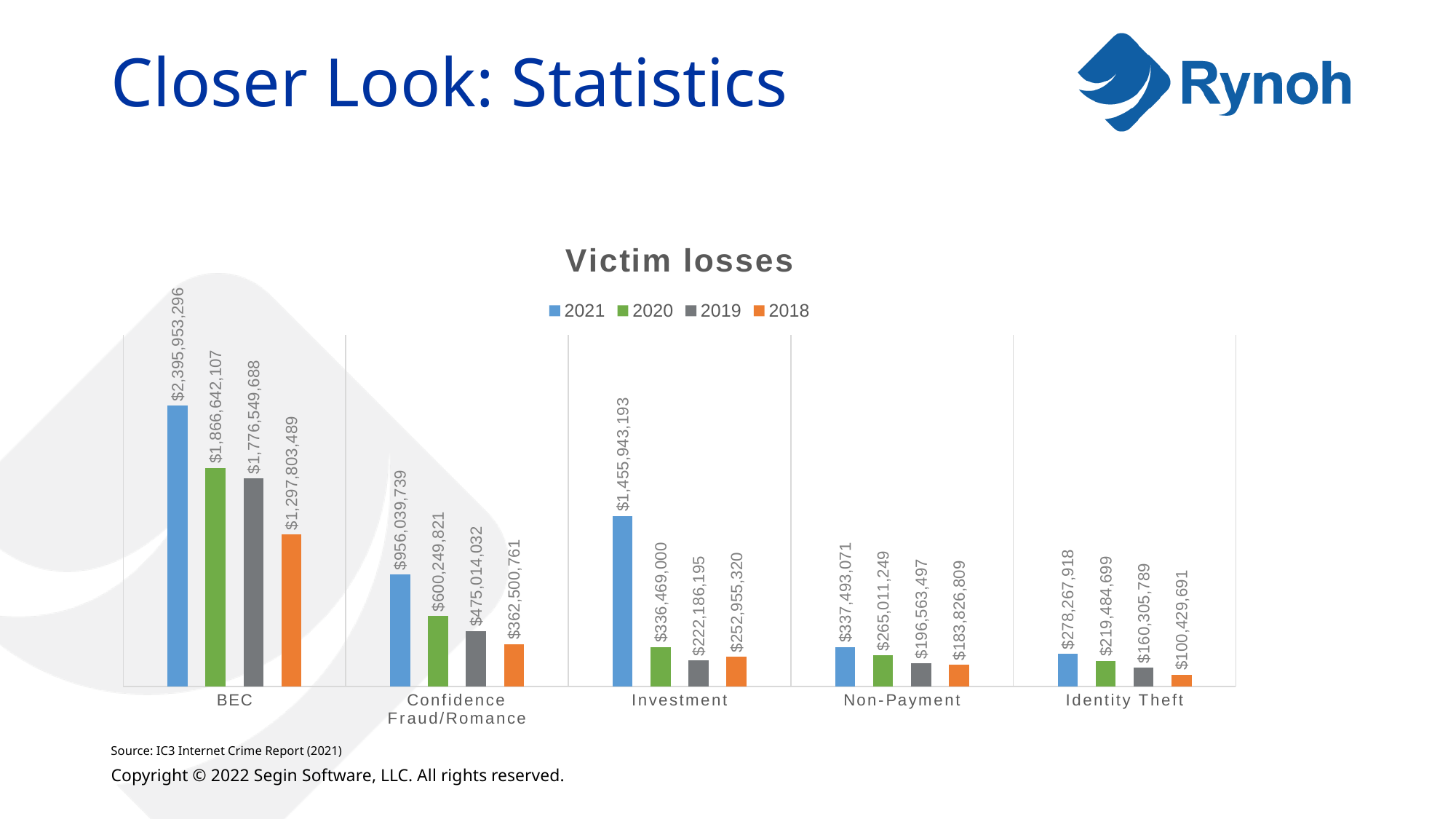
How many categories are shown on the x axis? 5 For Investment, which is larger: the 2019 value or the 2018 value? 2018 What is the difference between the 2021 and 2020 victim losses for BEC? $529,311,189 What kind of chart is shown? Bar chart What is the 2020 victim loss value for Investment? $336,469,000 What is the title of the chart? Victim losses Which category has the highest 2021 victim losses? BEC What is the 2018 victim loss value for Identity Theft? $100,429,691 What is the 2021 victim loss value for BEC? $2,395,953,296 How many series does the legend list? 4 What is the 2019 victim loss value for Non-Payment? $196,563,497 Which category has the lowest 2018 victim losses? Identity Theft